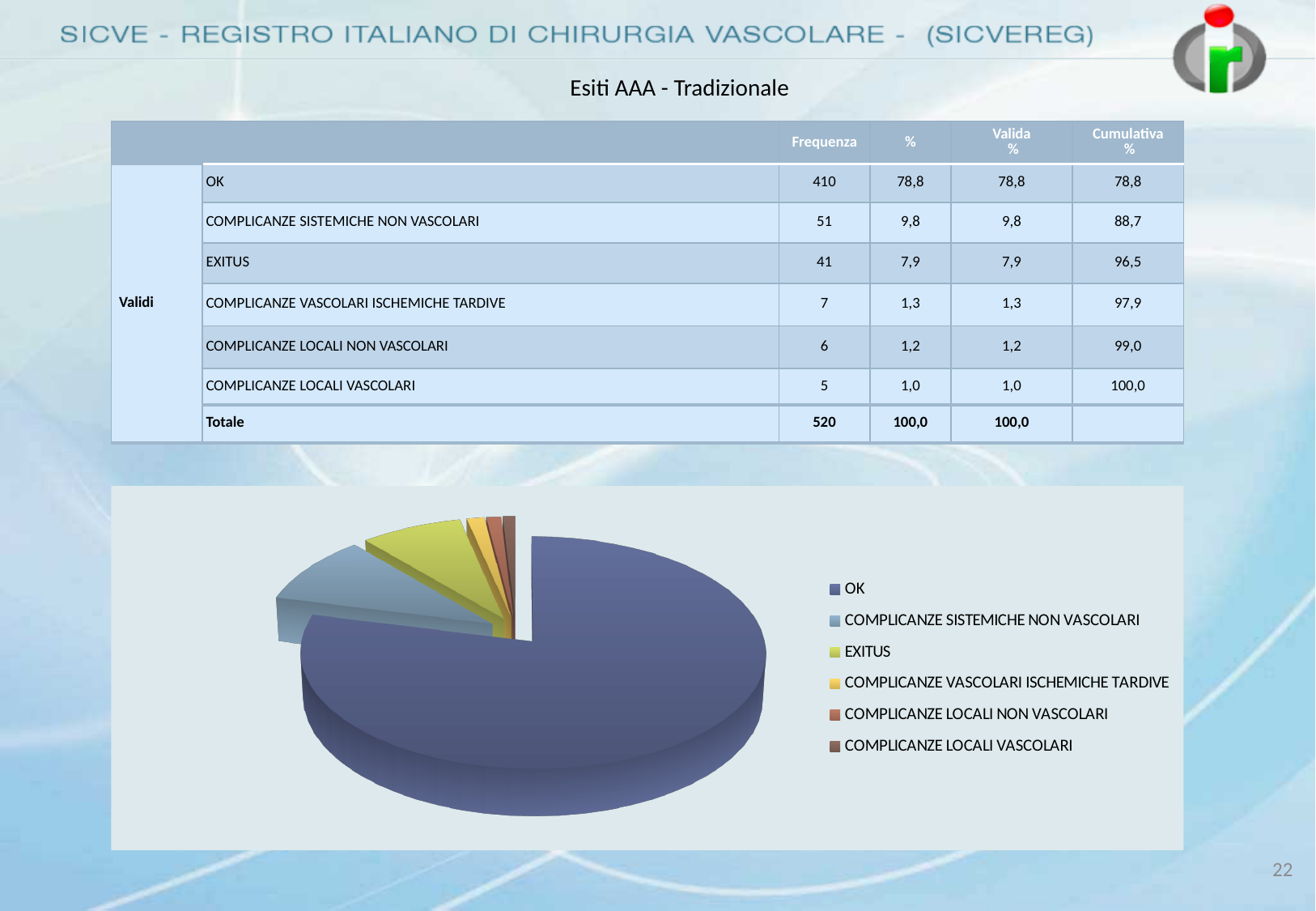
Which category has the smallest slice in the pie chart? COMPLICANZE LOCALI VASCOLARI Which slice is larger in the pie chart, OK or EXITUS? OK According to the table on the slide, what is the total frequency across all categories in the pie chart? 520 How many categories does the pie chart's legend list? 6 According to the table on the slide, what is the frequency for COMPLICANZE SISTEMICHE NON VASCOLARI? 51 Which legend entry in the pie chart is shown in light green/yellow-green? EXITUS Which slice is larger in the pie chart, EXITUS or COMPLICANZE SISTEMICHE NON VASCOLARI? COMPLICANZE SISTEMICHE NON VASCOLARI According to the table on the slide, what share of the pie does the OK slice represent? 78,8 Which category has the largest slice in the pie chart? OK What is the title shown above the table and pie chart on the slide? Esiti AAA - Tradizionale According to the table on the slide, what share of the pie does the EXITUS slice represent? 7,9 What kind of chart is shown on the slide? pie chart